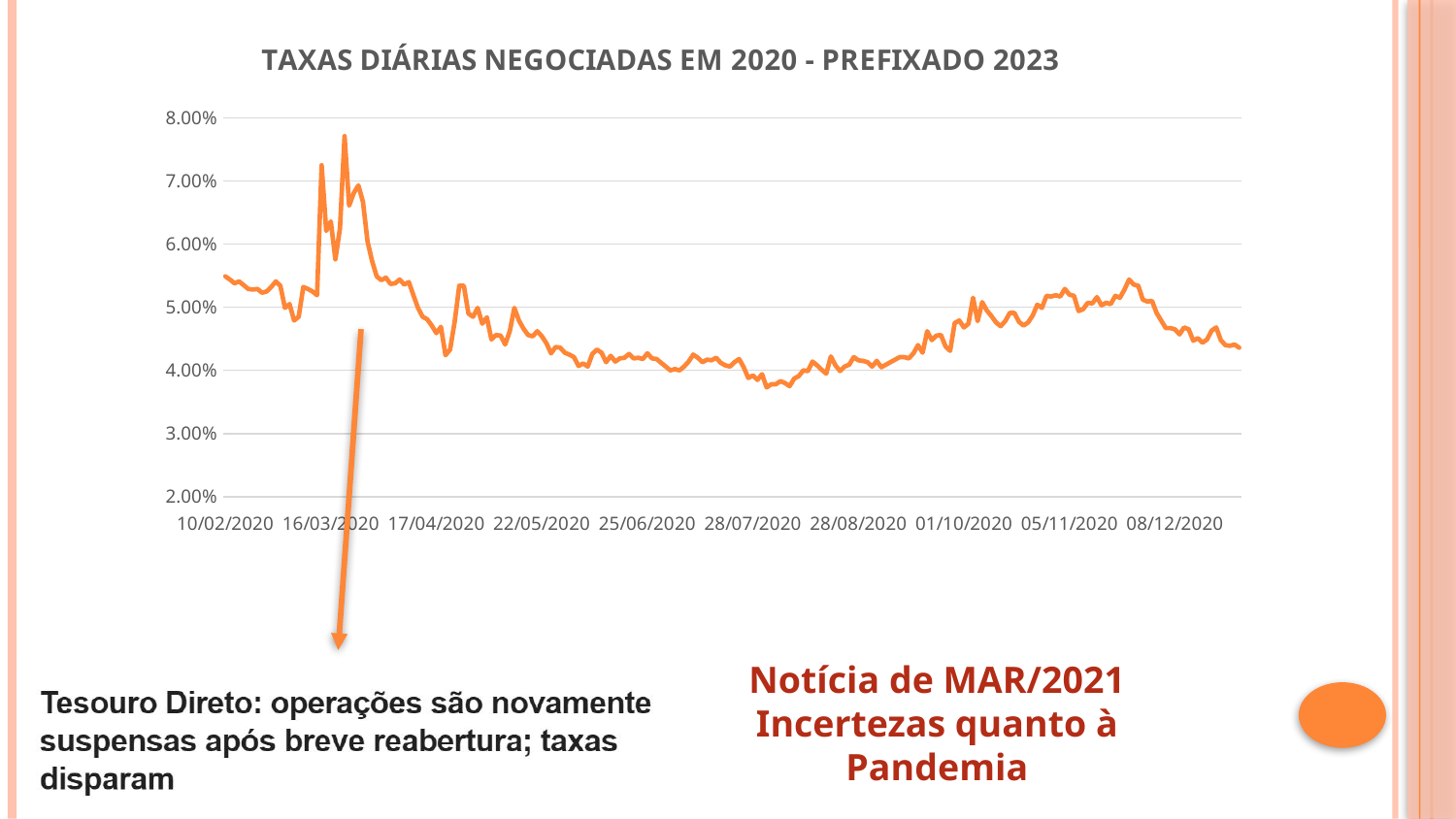
What kind of chart is shown on the slide? line chart Near which x-axis date label does the line reach its peak? 16/03/2020 How many date labels are shown on the x axis? 10 Is the highest value reached by the line greater or less than 7.00%? greater Does the line rise or fall between 16/03/2020 and 22/05/2020? fall Is the value at the start of the series (10/02/2020) greater or less than 5.00%? greater Is the value at the start of the series (10/02/2020) higher or lower than the value at the end (08/12/2020)? higher Is the lowest value reached by the line greater or less than 4.00%? less What is the title of the chart? TAXAS DIÁRIAS NEGOCIADAS EM 2020 - PREFIXADO 2023 Does the line rise or fall between 28/08/2020 and 05/11/2020? rise